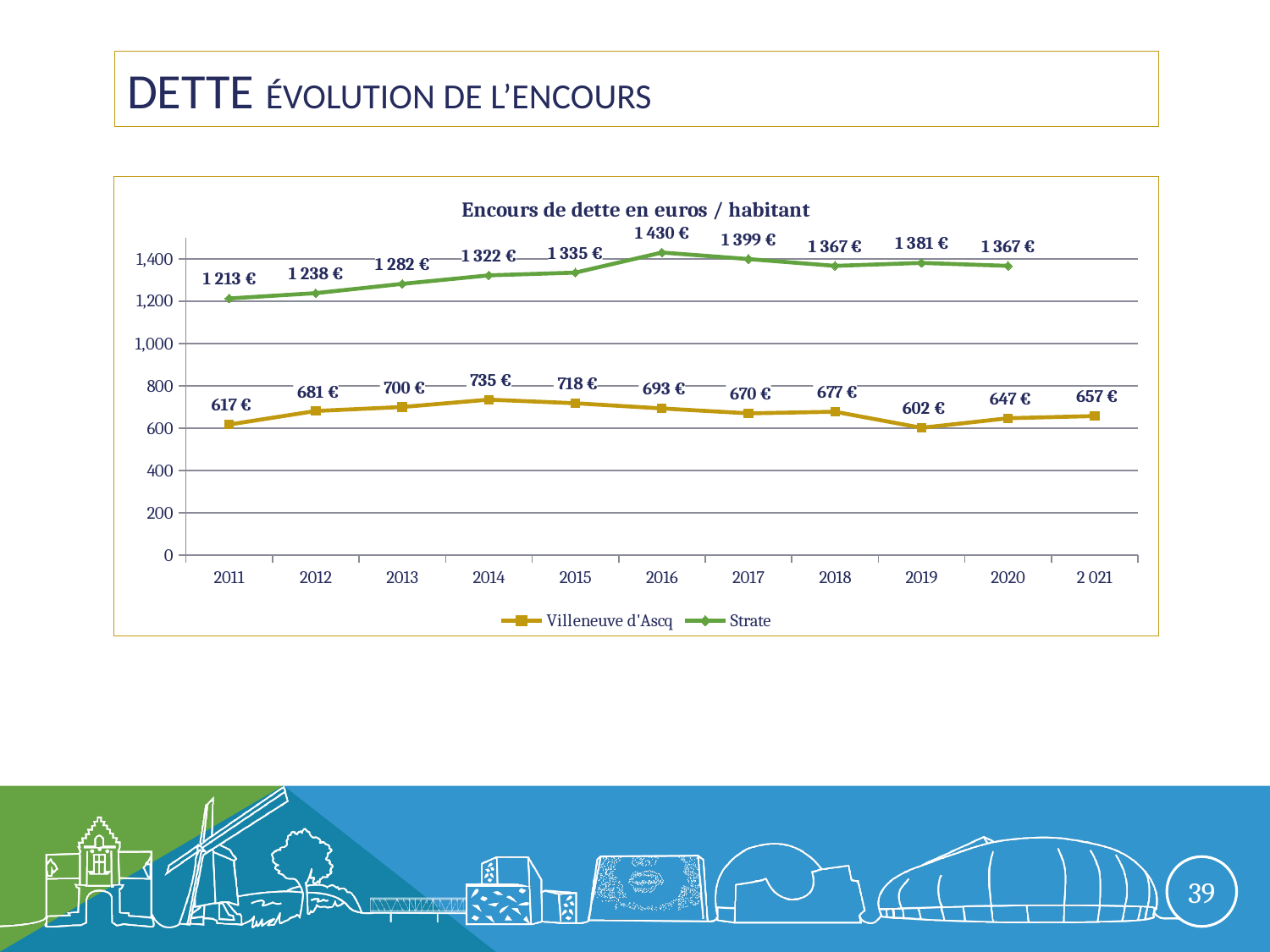
In which year is the Villeneuve d'Ascq value the lowest? 2019 Does the Strate value rise or fall from 2011 to 2016? Rise How many years are shown on the x axis? 11 In which year is the Strate value the highest? 2016 What is the value for Villeneuve d'Ascq in 2019? 602 € What is the title of the chart? Encours de dette en euros / habitant What is the value for Villeneuve d'Ascq in 2014? 735 € Which series has the higher value in 2018, Villeneuve d'Ascq or Strate? Strate What is the difference between the Strate value and the Villeneuve d'Ascq value in 2011? 596 € What type of chart is shown on the slide? Line chart How many series does the legend list? 2 What is the value for Strate in 2016? 1 430 €